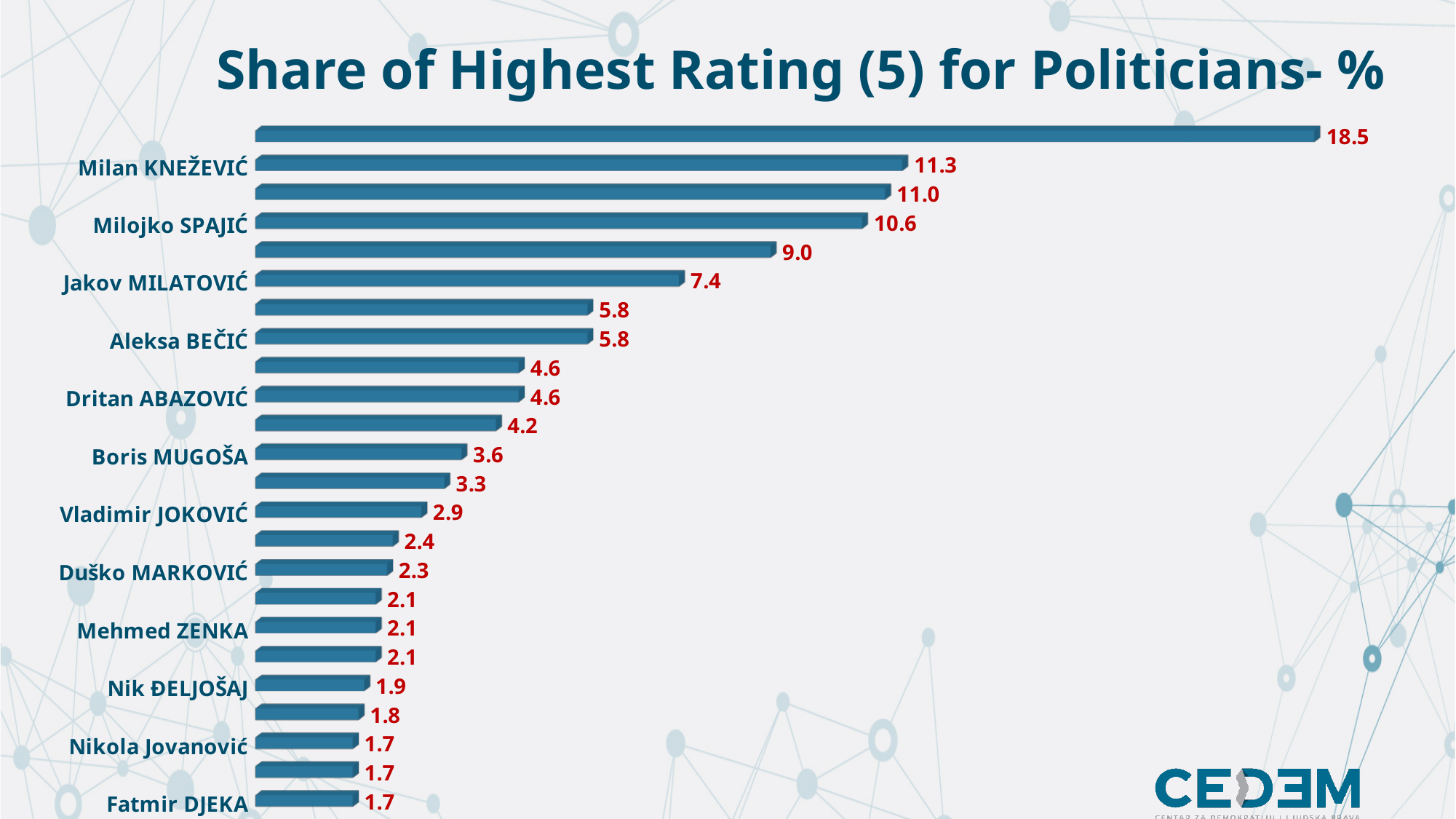
What is the value for Dritan ABAZOVIĆ? 4.6 What is the title of the chart? Share of Highest Rating (5) for Politicians- % What is the value for Milan KNEŽEVIĆ? 11.3 What is the value for Milojko SPAJIĆ? 10.6 What is the largest value shown on the chart? 18.5 What kind of chart is shown on the slide? Bar chart What is the value for Jakov MILATOVIĆ? 7.4 Which has a larger value, Boris MUGOŠA or Vladimir JOKOVIĆ? Boris MUGOŠA What is the difference between the values for Milan KNEŽEVIĆ and Milojko SPAJIĆ? 0.7 What is the smallest value shown on the chart? 1.7 What is the value for Nik ĐELJOŠAJ? 1.9 How many bars are plotted on the chart? 24